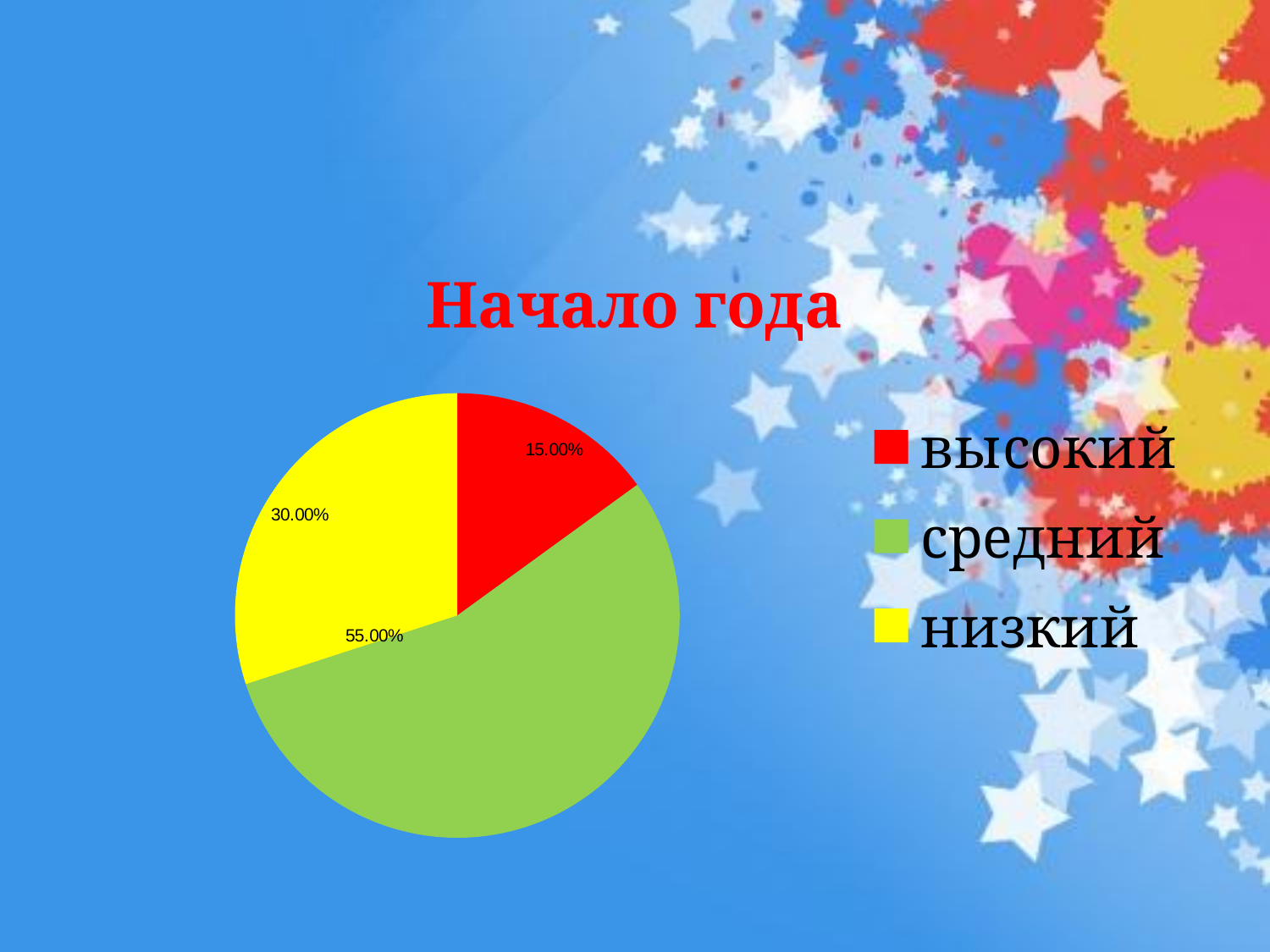
What colour is the "средний" slice in the pie chart? green What share of the pie does the "высокий" slice have? 15.00% Which category has the smallest slice of the pie? высокий What share of the pie does the "низкий" slice have? 30.00% What share of the pie does the "средний" slice have? 55.00% What kind of chart is shown on the slide? pie chart Which category has the largest slice of the pie? средний What is the difference between the "средний" and "низкий" shares? 25.00% What is the title of the chart? Начало года How many categories does the pie chart show? 3 What is the difference between the "низкий" and "высокий" shares? 15.00% Which is larger, the "низкий" slice or the "высокий" slice? низкий